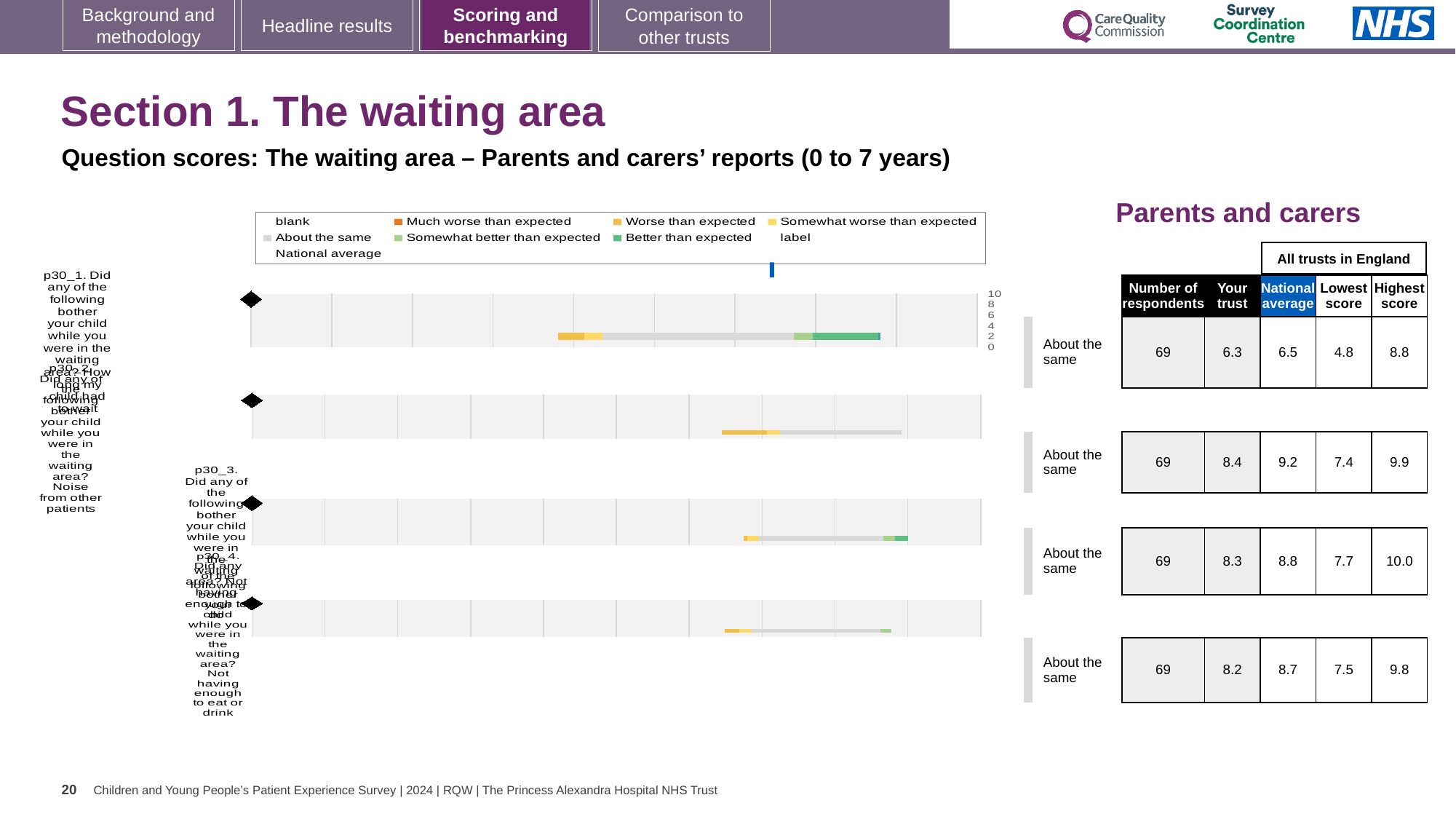
In the table to the right of the chart, what is the national average for the second question (p30_2)? 9.2 What colour does the legend use for 'Much worse than expected'? orange In the table to the right of the chart, what is the highest score for the third question (p30_3)? 10.0 How many bars (questions) are plotted in the chart? 4 In the table to the right of the chart, what is the 'Your trust' score for the first question (p30_1)? 6.3 In the table to the right of the chart, what is the lowest score for the fourth question (p30_4)? 7.5 For the second question (p30_2), which is larger: the 'Your trust' score or the national average? National average What kind of chart is shown on the slide? bar chart How many entries does the chart legend list? 9 In the table to the right of the chart, what is the number of respondents for the first question (p30_1)? 69 For the second question (p30_2), what is the difference between the national average (9.2) and the 'Your trust' score (8.4)? 0.8 What colour does the legend use for 'Better than expected'? green